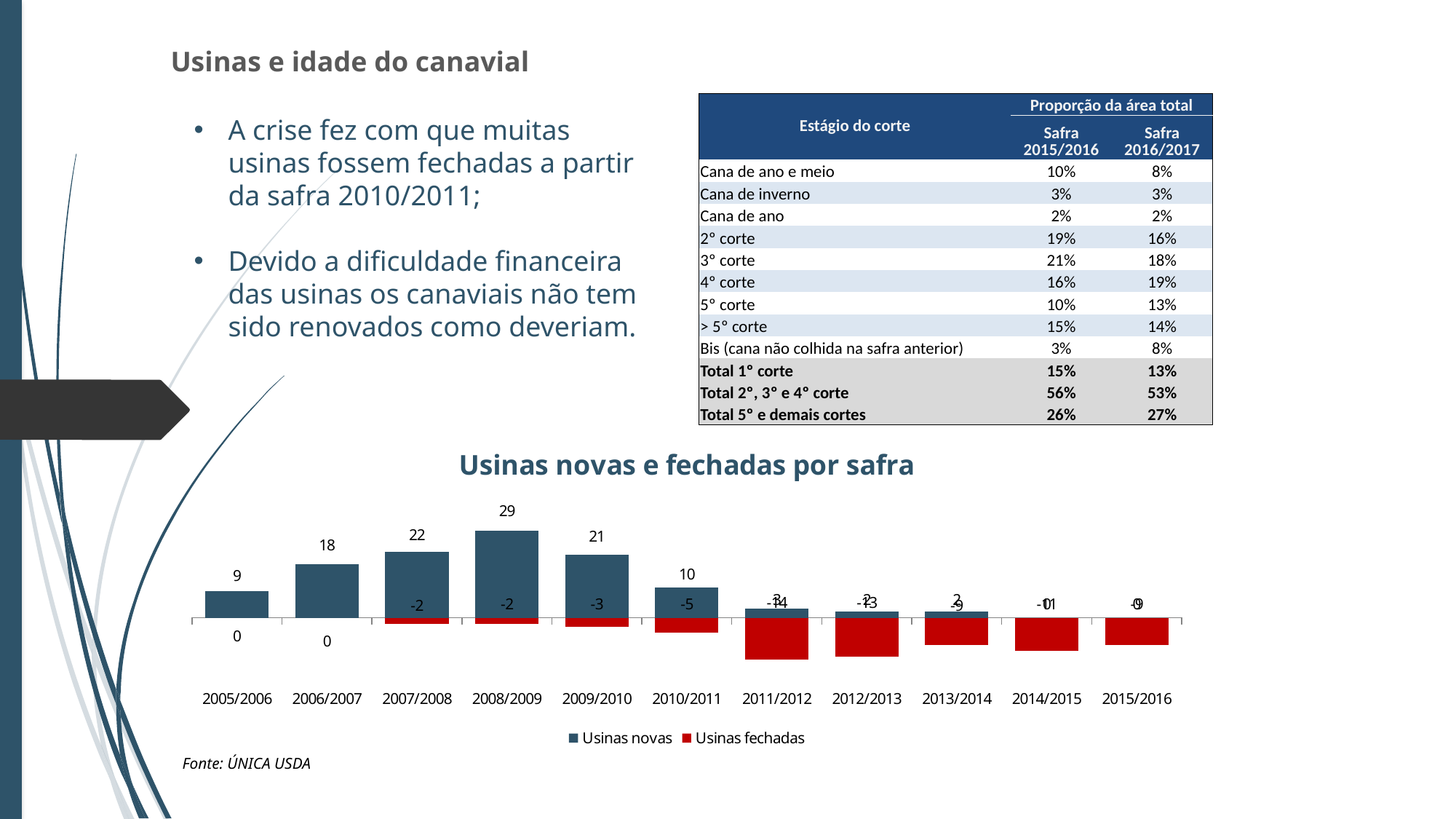
What type of chart is shown on the slide? Bar chart In which safra is the value of Usinas novas the highest? 2008/2009 What is the difference between Usinas novas in 2008/2009 and in 2006/2007? 11 How many safras (categories) are shown on the x axis of the chart? 11 What is the value of Usinas fechadas for 2009/2010? -3 What is the value of Usinas novas for 2006/2007? 18 Which is larger, Usinas novas in 2007/2008 or in 2010/2011? 2007/2008 What is the value of Usinas novas for 2008/2009? 29 Do the values of Usinas novas rise or fall from 2008/2009 to 2010/2011? Fall What is the title of the chart on the slide? Usinas novas e fechadas por safra How many series does the chart legend list? 2 What is the value of Usinas fechadas for 2010/2011? -5